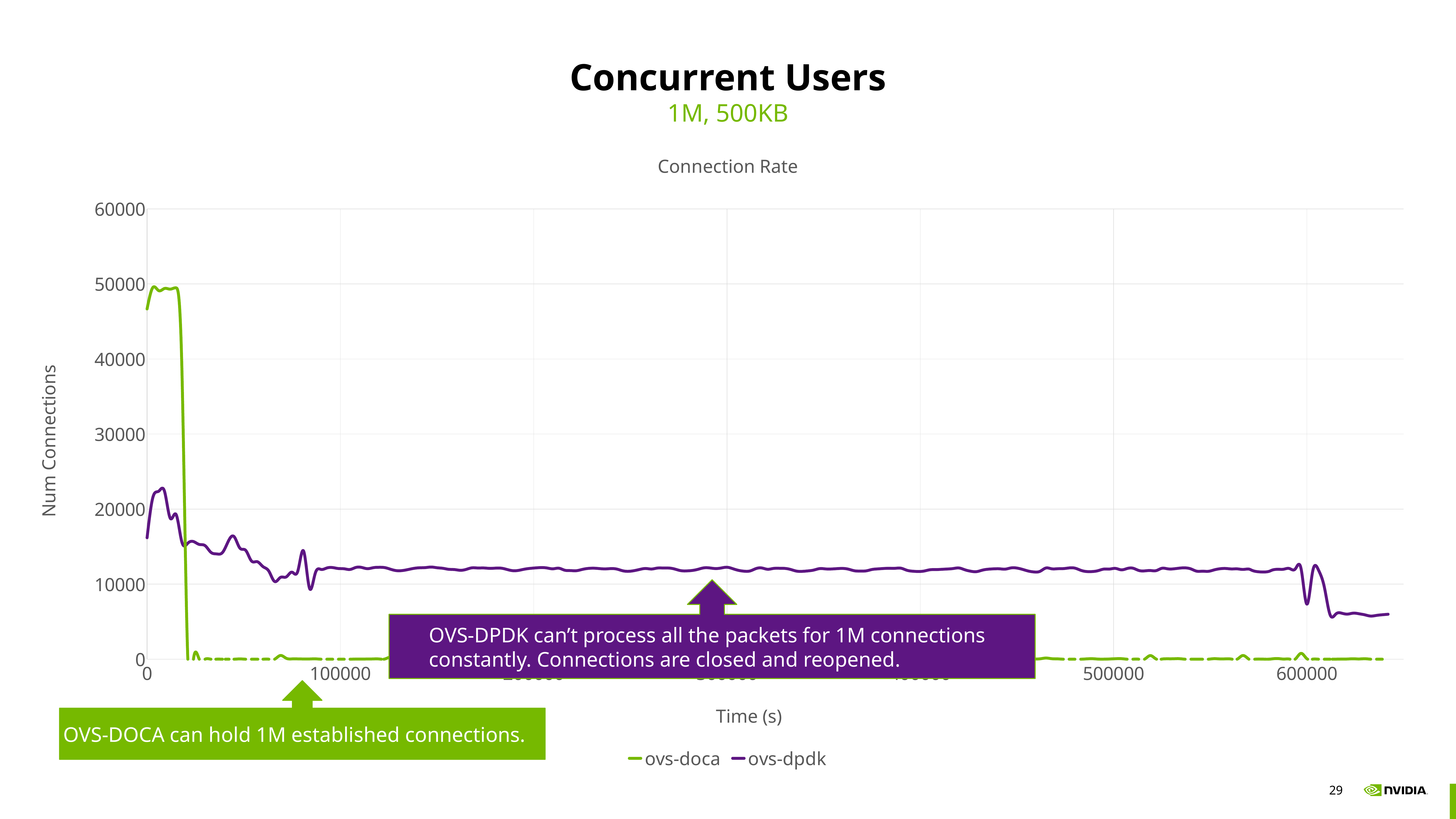
Which series reaches the highest value anywhere on the chart? ovs-doca Is the value for ovs-dpdk at time 300000 greater or less than 10000? greater What kind of chart is shown on the slide? line chart What is the label of the y axis? Num Connections Is the value for ovs-doca at time 300000 greater or less than 10000? less Is the value for ovs-dpdk at time 300000 greater or less than 20000? less Which series has the higher value at time 500000, ovs-doca or ovs-dpdk? ovs-dpdk How many series does the chart legend list? 2 What is the title of the chart? Connection Rate Does the ovs-doca series rise or fall between time 0 and time 100000? fall